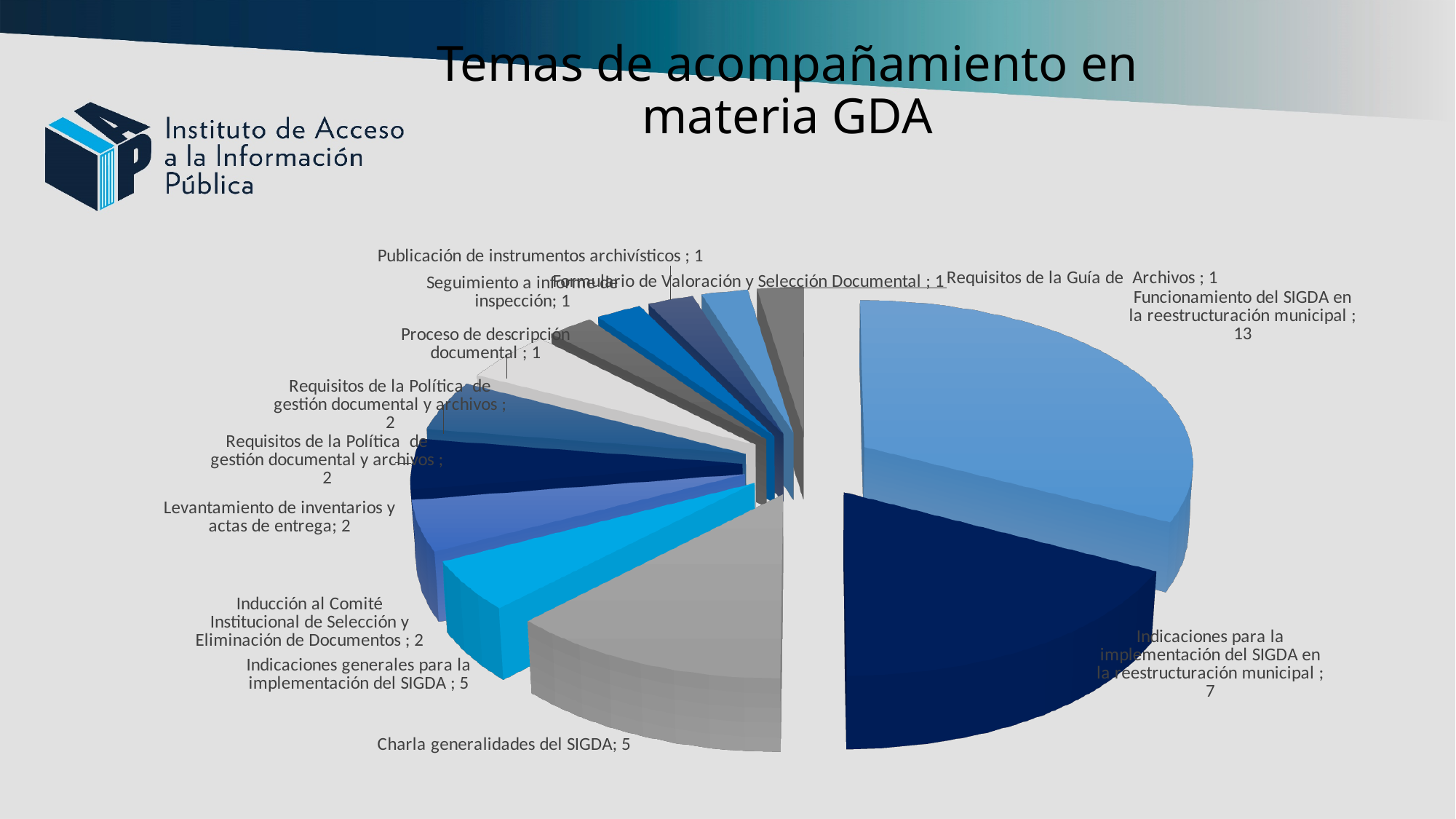
Which category has the largest slice in the pie chart? Funcionamiento del SIGDA en la reestructuración municipal What is the value for 'Indicaciones para la implementación del SIGDA en la reestructuración municipal'? 7 What is the value for 'Charla generalidades del SIGDA'? 5 What is the value for 'Inducción al Comité Institucional de Selección y Eliminación de Documentos'? 2 What kind of chart is shown on the slide? pie chart What is the value for 'Funcionamiento del SIGDA en la reestructuración municipal'? 13 Which is larger: the value for 'Charla generalidades del SIGDA' or the value for 'Proceso de descripción documental'? Charla generalidades del SIGDA What is the title of the chart on the slide? Temas de acompañamiento en materia GDA What is the value for 'Levantamiento de inventarios y actas de entrega'? 2 What is the value for 'Requisitos de la Guía de Archivos'? 1 What is the difference between the values for 'Funcionamiento del SIGDA en la reestructuración municipal' and 'Indicaciones para la implementación del SIGDA en la reestructuración municipal'? 6 What is the difference between the values for 'Indicaciones generales para la implementación del SIGDA' and 'Levantamiento de inventarios y actas de entrega'? 3